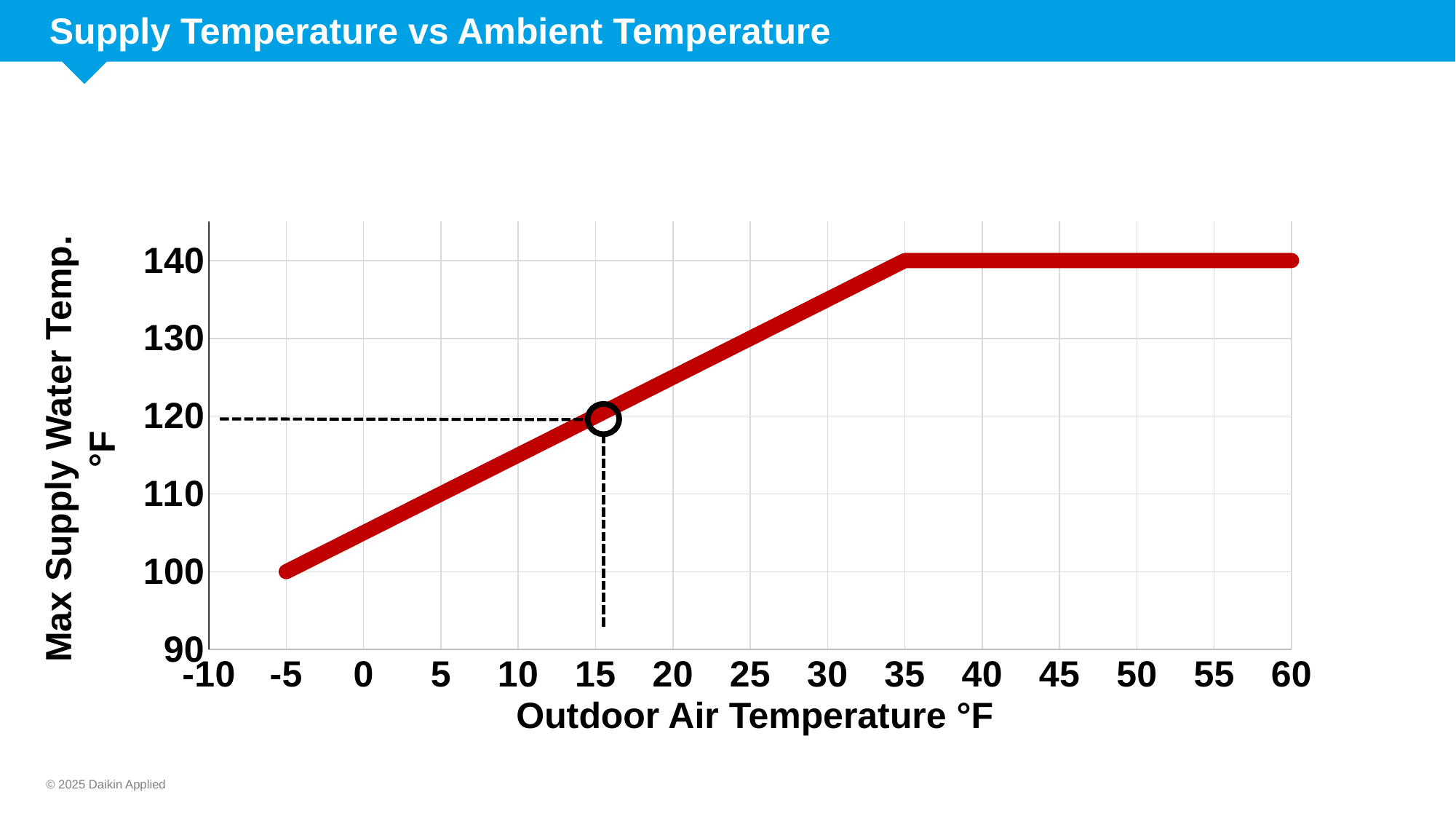
Is the max supply water temperature at an outdoor air temperature of 45 °F greater or less than 130? greater What is the lowest max supply water temperature shown on the line? 100 What is the max supply water temperature at an outdoor air temperature of 60 °F? 140 What is the max supply water temperature at an outdoor air temperature of 35 °F? 140 How does the max supply water temperature change as outdoor air temperature increases from -5 °F to 60 °F? rises until 35 °F, then stays flat at 140 What is the highest max supply water temperature reached by the line? 140 What is the difference between the highest and lowest max supply water temperatures on the line? 40 What is the max supply water temperature at an outdoor air temperature of -5 °F? 100 What is the title of the x axis? Outdoor Air Temperature °F What kind of chart is shown on the slide? line chart Is the max supply water temperature at an outdoor air temperature of 10 °F greater or less than 110? greater What max supply water temperature does the circled point on the line correspond to? 120